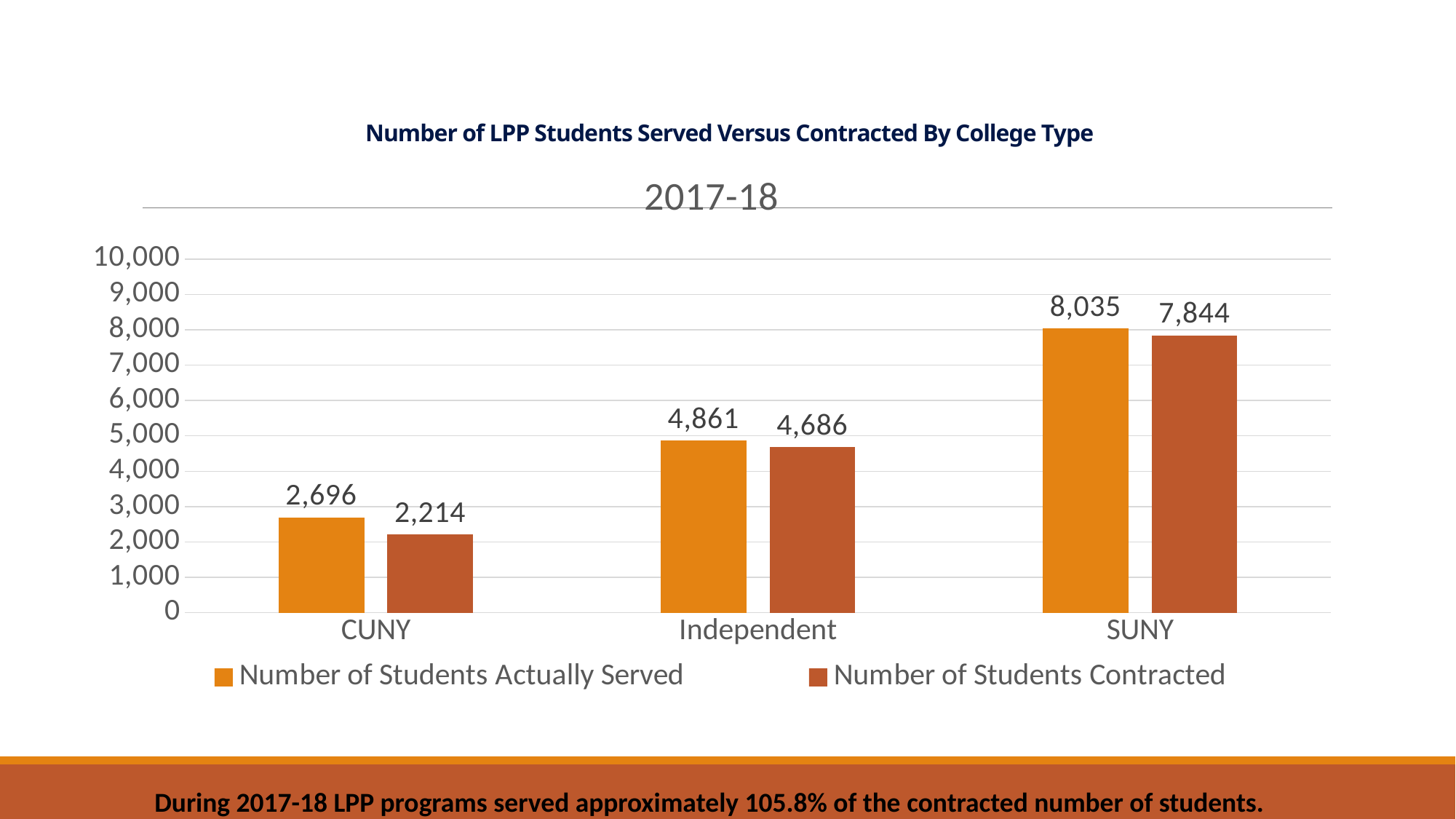
How many college types are shown on the x axis? 3 Which college type has the lowest Number of Students Contracted? CUNY What is the difference between the Number of Students Actually Served and the Number of Students Contracted for CUNY? 482 How many series does the legend list? 2 Is the Number of Students Contracted for SUNY greater or less than 7,000? greater What kind of chart is shown on the slide? Bar chart What is the Number of Students Contracted for Independent colleges? 4,686 Which college type has the highest Number of Students Actually Served? SUNY What is the Number of Students Contracted for SUNY? 7,844 What is the difference between the Number of Students Actually Served for SUNY and for Independent colleges? 3,174 For Independent colleges, which is larger: the Number of Students Actually Served or the Number of Students Contracted? Number of Students Actually Served What is the Number of Students Actually Served for CUNY? 2,696